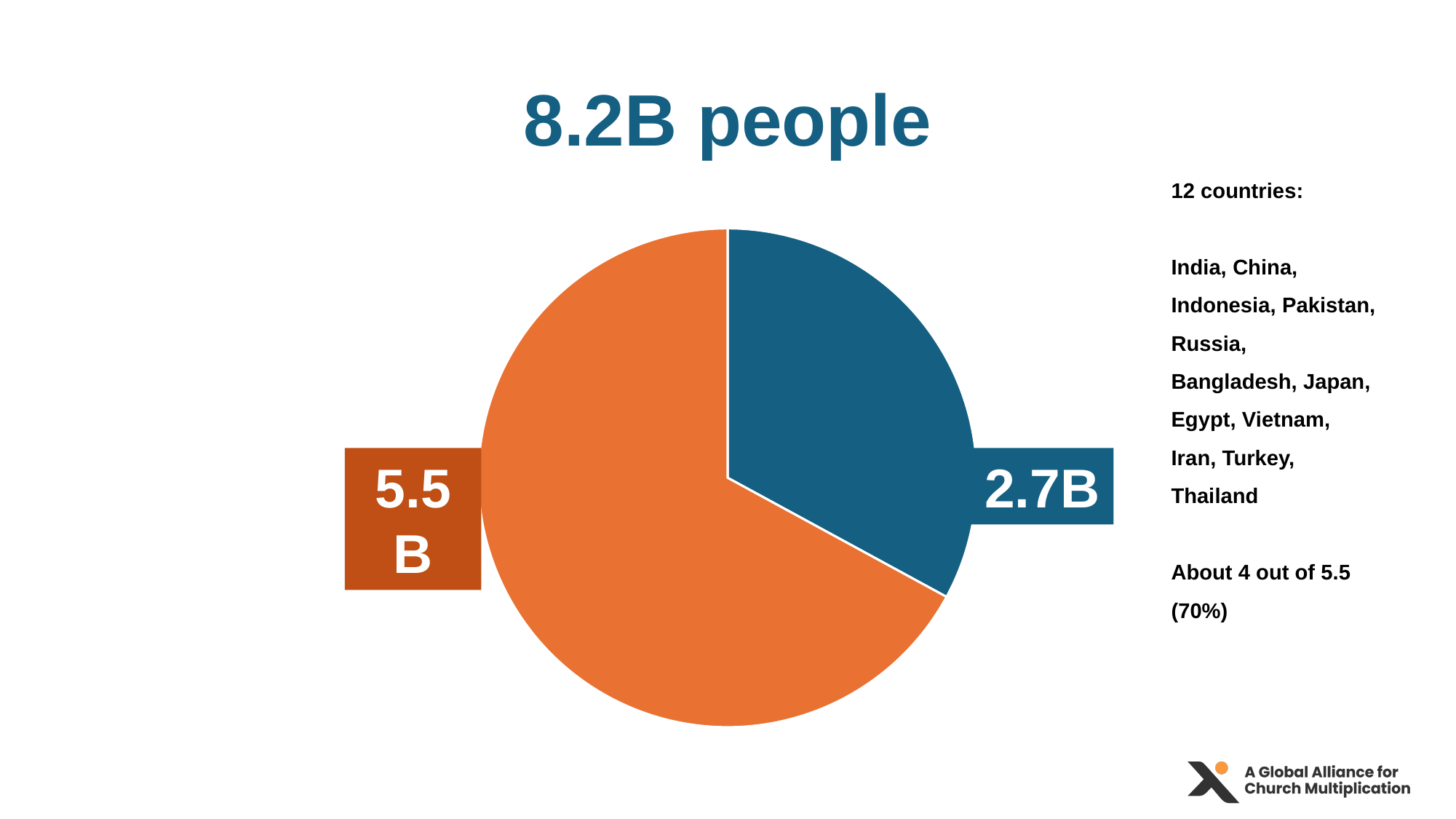
What type of chart is shown on the slide? pie chart Which slice of the pie chart is larger, the orange one or the blue one? orange What is the total number of people represented by the pie chart, as stated in the slide title? 8.2B people How many countries does the text beside the pie chart say the blue slice covers? 12 countries How many slices does the pie chart have? 2 What is the difference between the orange slice value and the blue slice value in the pie chart? 2.8B Which slice of the pie chart has the lowest value? the blue slice (2.7B) Which slice of the pie chart has the highest value? the orange slice (5.5 B) What is the title shown above the pie chart? 8.2B people What value is labelled on the orange slice of the pie chart? 5.5 B What value is labelled on the blue slice of the pie chart? 2.7B